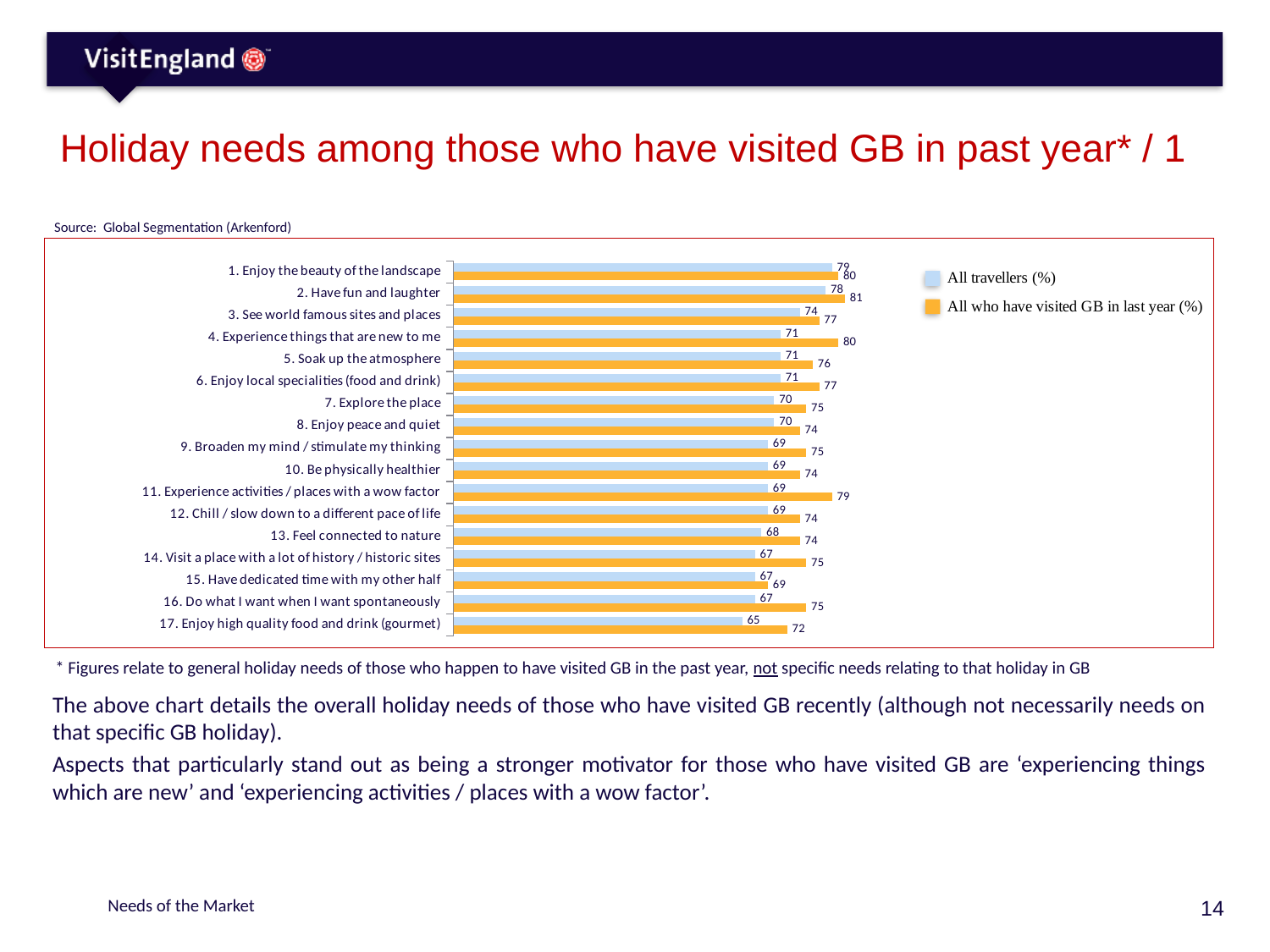
For '2. Have fun and laughter', which series has the larger value? All who have visited GB in last year (%) Which category has the lowest value for 'All travellers (%)'? 17. Enjoy high quality food and drink (gourmet) What is the difference between the two series for '4. Experience things that are new to me'? 9 How many series does the legend list? 2 What is the value for 'All who have visited GB in last year (%)' for '11. Experience activities / places with a wow factor'? 79 How many categories are shown in the chart? 17 Which category has the lowest value for 'All who have visited GB in last year (%)'? 15. Have dedicated time with my other half What is the difference between the two series for '11. Experience activities / places with a wow factor'? 10 What kind of chart is shown on the slide? Bar chart What is the value for 'All who have visited GB in last year (%)' for '4. Experience things that are new to me'? 80 Which category has the highest value for 'All who have visited GB in last year (%)'? 2. Have fun and laughter What is the value for 'All travellers (%)' for '17. Enjoy high quality food and drink (gourmet)'? 65